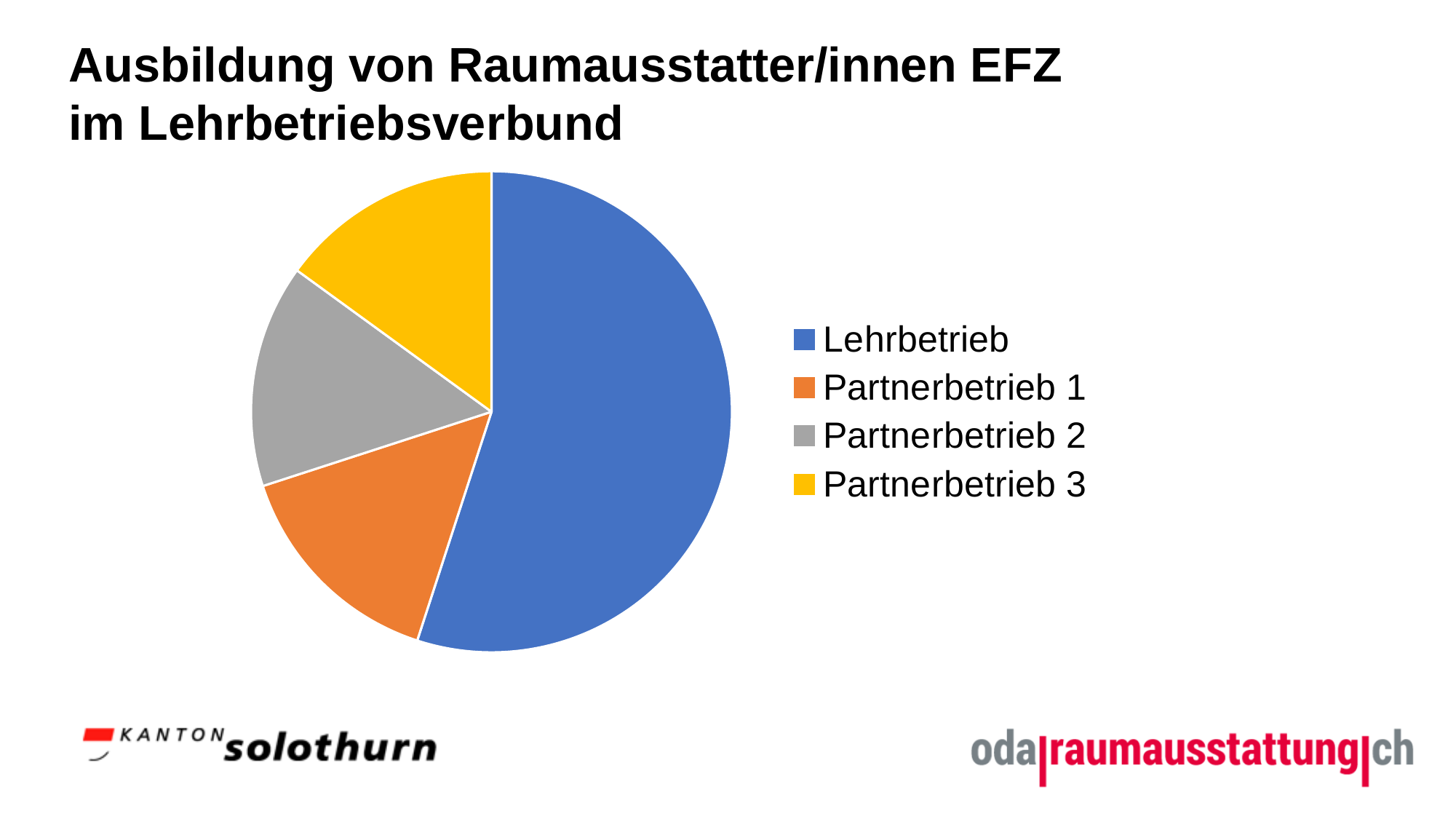
What kind of chart is shown on the slide? pie chart Which is larger in the pie chart, Partnerbetrieb 2 or Lehrbetrieb? Lehrbetrieb What is the title of the slide containing the pie chart? Ausbildung von Raumausstatter/innen EFZ im Lehrbetriebsverbund Which is larger in the pie chart, Lehrbetrieb or Partnerbetrieb 3? Lehrbetrieb Which category has the largest slice of the pie chart? Lehrbetrieb Which is larger in the pie chart, Lehrbetrieb or Partnerbetrieb 1? Lehrbetrieb Which colour represents Partnerbetrieb 3 in the pie chart? yellow How many slices does the pie chart have? 4 How many entries does the legend of the pie chart list? 4